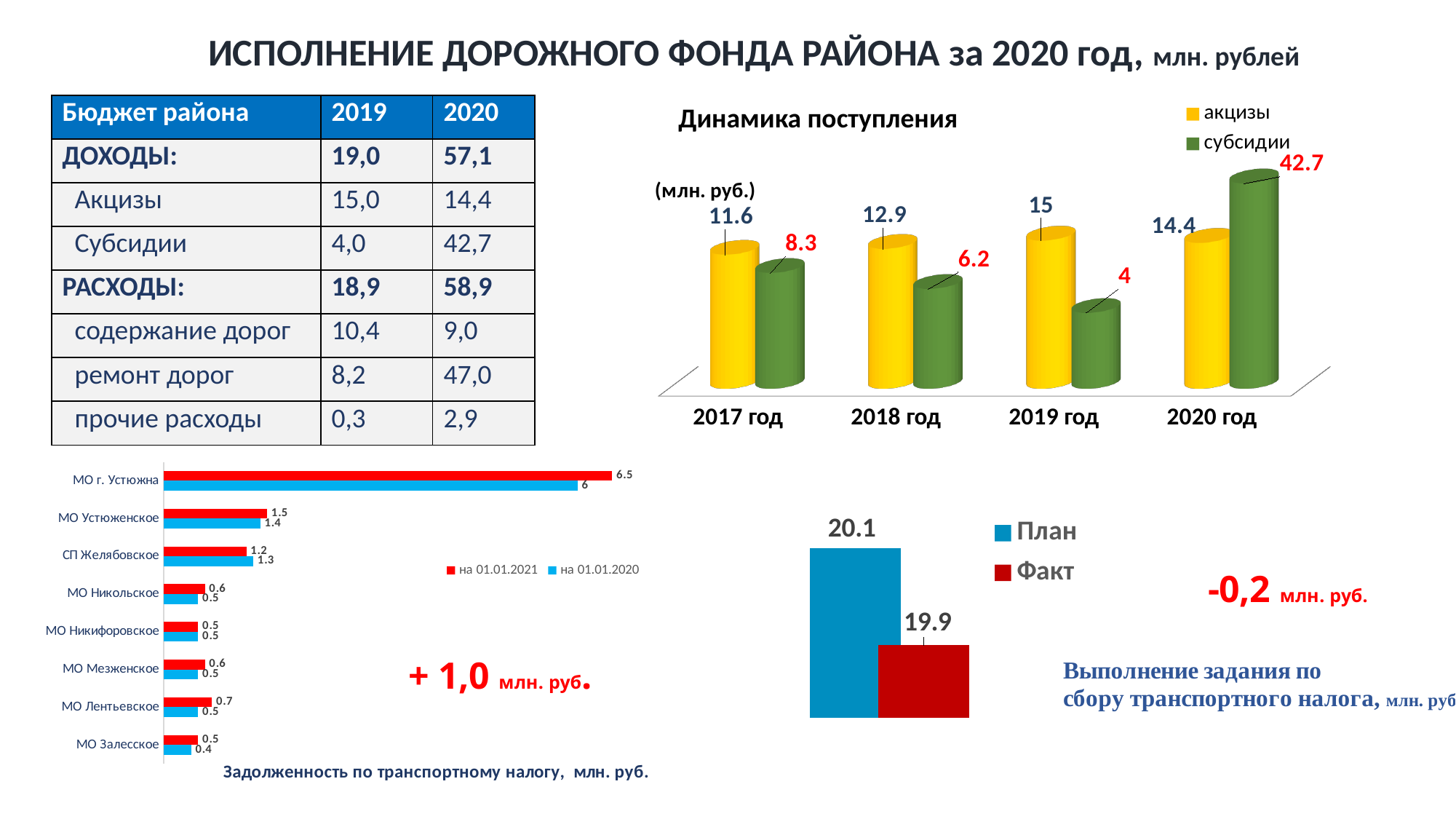
In the 'Динамика поступления' chart, how many series does the legend list? 2 In the 'Выполнение задания по сбору транспортного налога' chart, what is the value for Факт? 19.9 In the 'Динамика поступления' chart, what is the value for акцизы in 2018 год? 12.9 In the 'Динамика поступления' chart, do the values for субсидии rise or fall from 2017 год to 2019 год? fall In the 'Динамика поступления' chart, what is the value for субсидии in 2020 год? 42.7 In the 'Задолженность по транспортному налогу' chart, what is the value for МО Лентьевское на 01.01.2020? 0.5 In the 'Выполнение задания по сбору транспортного налога' chart, what is the difference between План and Факт? 0.2 In the 'Динамика поступления' chart, which year has the lowest value for субсидии? 2019 год In the 'Динамика поступления' chart, what is the difference between акцизы and субсидии in 2017 год? 3.3 In the 'Задолженность по транспортному налогу' chart, how many municipalities are listed? 8 In the 'Задолженность по транспортному налогу' chart, what is the value for МО г. Устюжна на 01.01.2021? 6.5 In the 'Задолженность по транспортному налогу' chart, which is larger for СП Желябовское: the value на 01.01.2021 or на 01.01.2020? на 01.01.2020